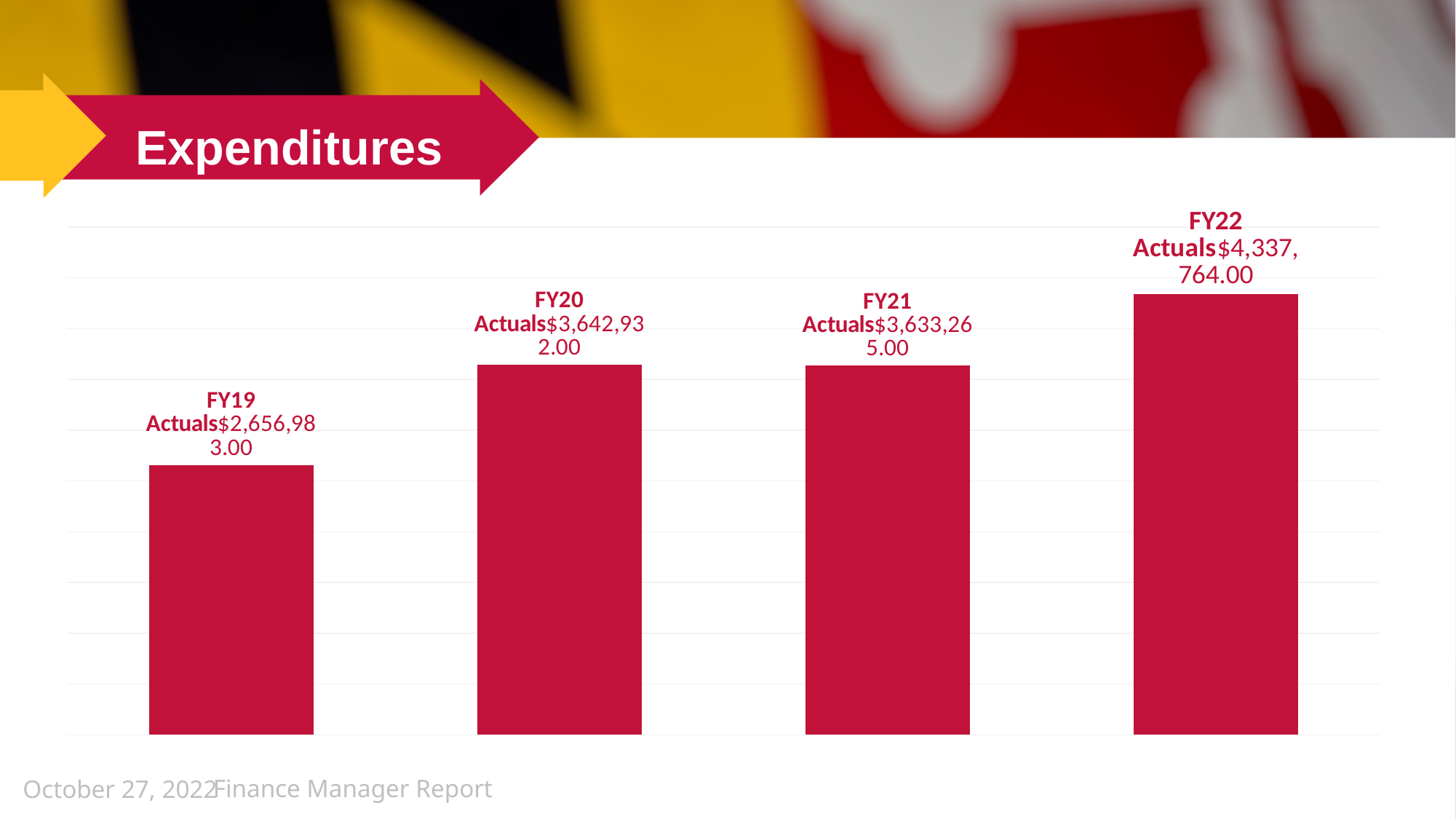
What is the title of the slide containing the chart? Expenditures What is the value for FY22 Actuals? $4,337,764.00 What is the difference between FY20 Actuals and FY21 Actuals? $9,667.00 Which fiscal year has the lowest expenditures? FY19 What is the value for FY19 Actuals? $2,656,983.00 What is the value for FY21 Actuals? $3,633,265.00 How many fiscal years are shown in the chart? 4 Which is larger, FY20 Actuals or FY21 Actuals? FY20 Actuals What is the value for FY20 Actuals? $3,642,932.00 What is the difference between FY22 Actuals and FY19 Actuals? $1,680,781.00 What kind of chart is shown on the slide? Bar chart Which fiscal year has the highest expenditures? FY22